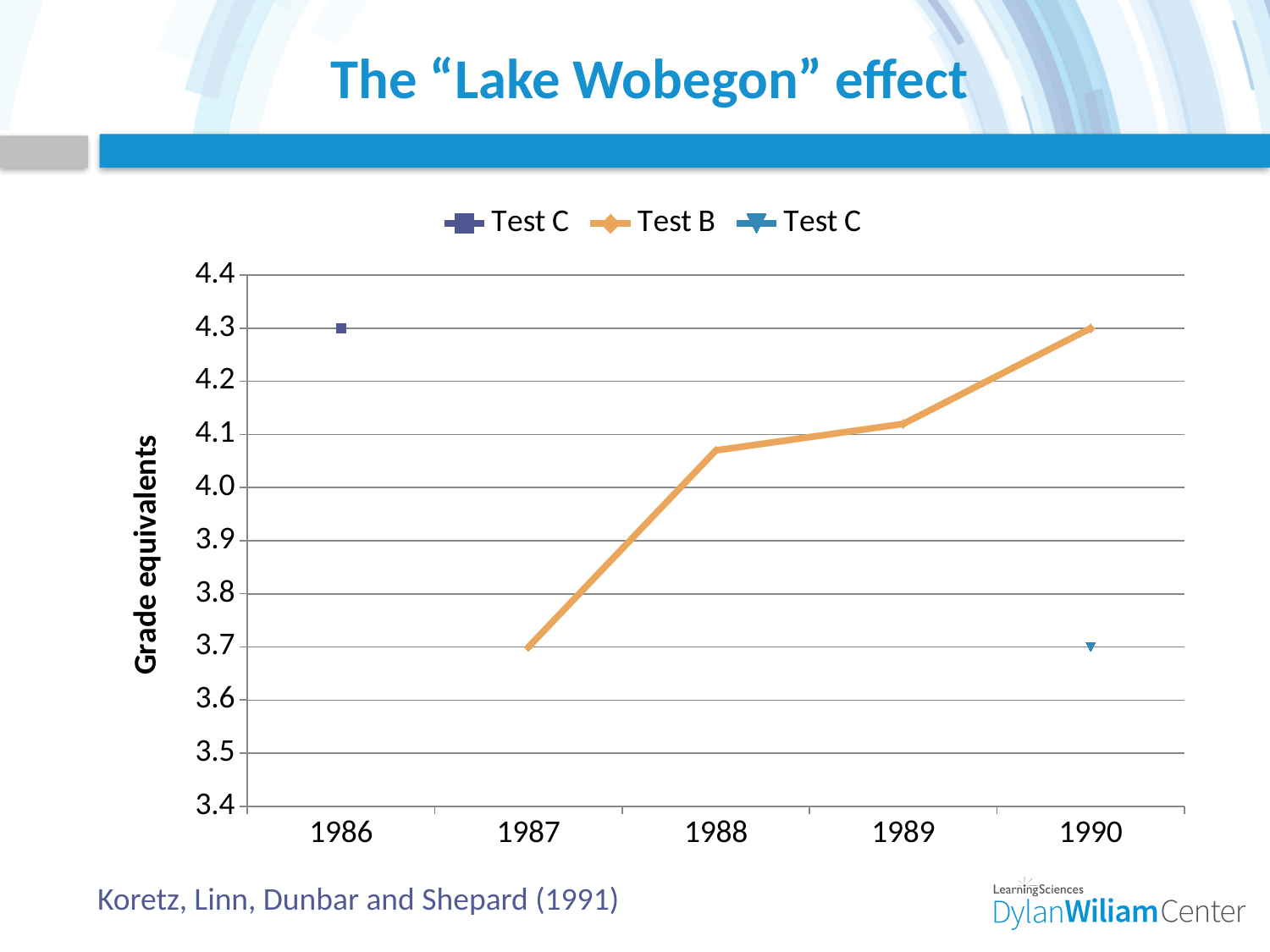
Is the Test B value for 1988 greater or less than 4.0? greater What is the value of the Test C point plotted at 1990? 3.7 What is the title of the y axis? Grade equivalents What kind of chart is shown on the slide? line chart What is the Test B value in 1990? 4.3 What is the difference between the Test B values in 1990 and 1987? 0.6 Is the Test B value for 1989 greater or less than 4.2? less Does the Test B line rise or fall from 1987 to 1990? rise How many years are shown on the x axis? 5 What is the value of the Test C point plotted at 1986? 4.3 What is the Test B value in 1987? 3.7 How many series does the legend list? 3